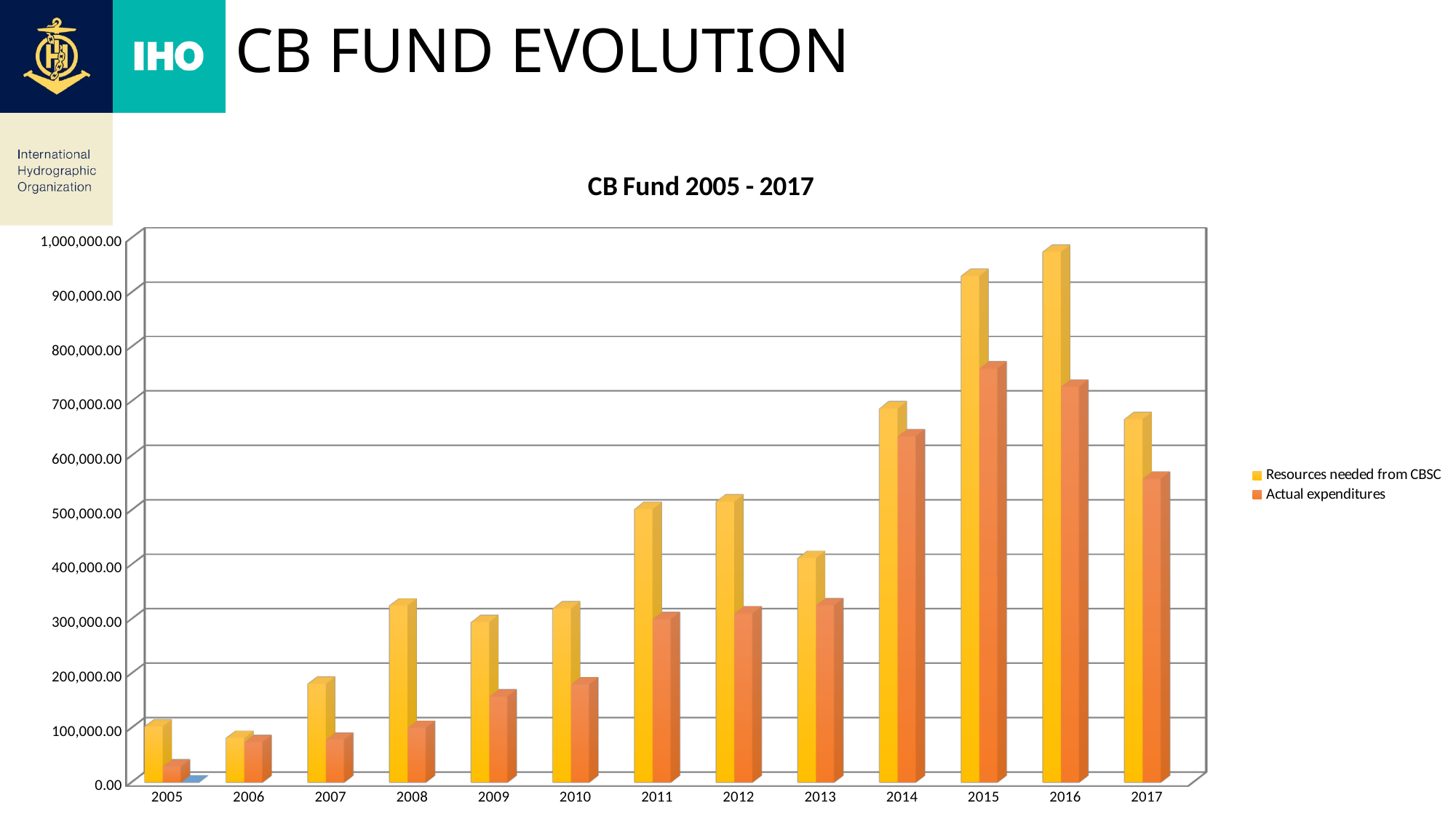
In which year is the value for Actual expenditures lowest? 2005 Is the value for Actual expenditures in 2017 greater or less than 600,000.00? less What kind of chart is shown on the slide? Bar chart How many years are shown on the x axis? 13 Do the values for Resources needed from CBSC generally rise or fall from 2005 to 2016? rise In which year is the value for Actual expenditures highest? 2015 In which year is the value for Resources needed from CBSC highest? 2016 Is the value for Resources needed from CBSC in 2015 greater or less than 900,000.00? greater In 2014, which is larger: Resources needed from CBSC or Actual expenditures? Resources needed from CBSC Is the value for Resources needed from CBSC in 2007 greater or less than 200,000.00? less What is the title of the chart? CB Fund 2005 - 2017 How many series does the legend list? 2